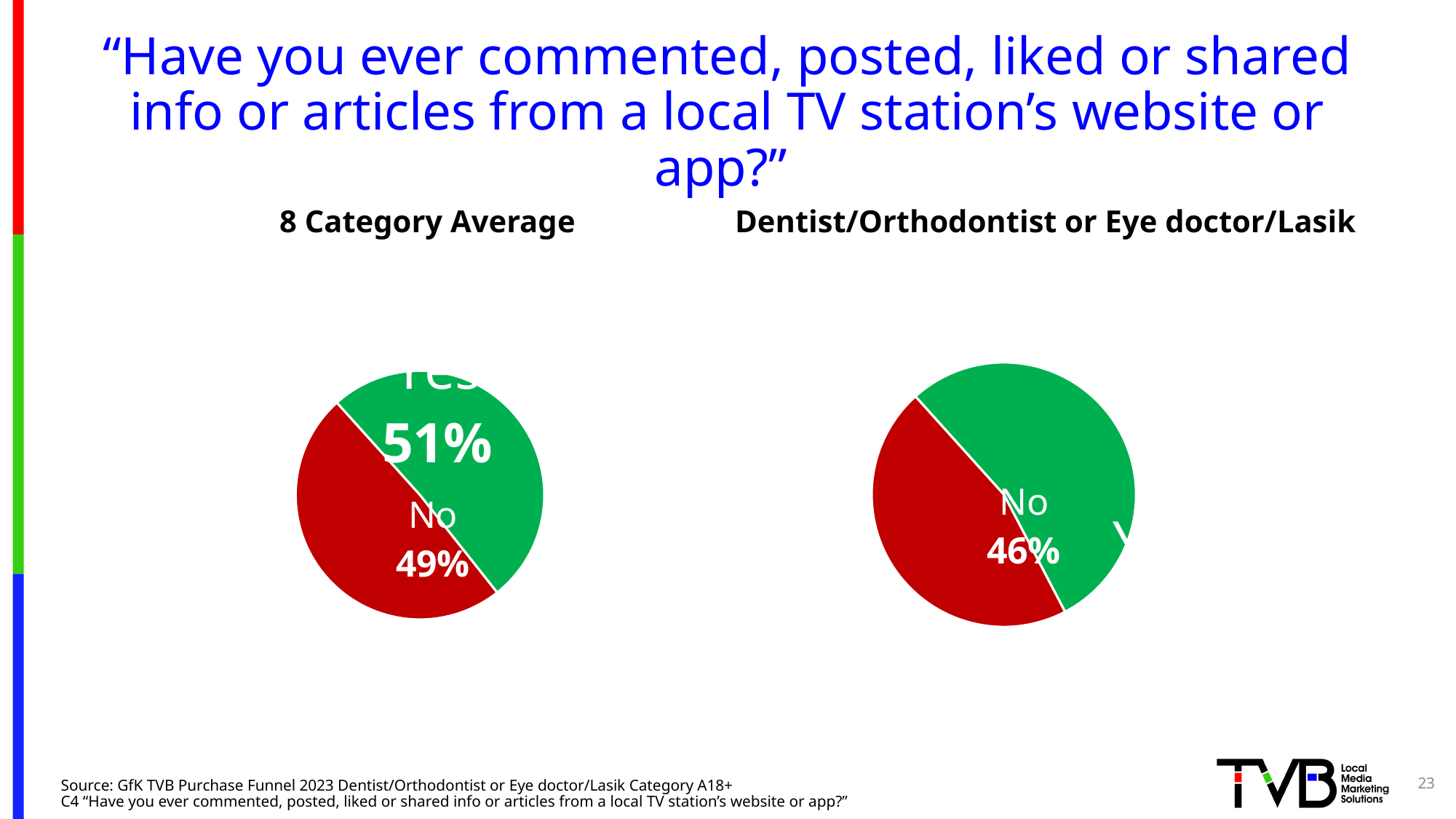
What colour represents the No slice in the pie charts? Red In the Dentist/Orthodontist or Eye doctor/Lasik pie chart, what percentage answered No? 46% What type of chart is used for the 8 Category Average? Pie chart How many pie charts are shown on the slide? 2 In the 8 Category Average pie chart, what percentage answered Yes? 51% In the 8 Category Average pie chart, which response has the larger share, Yes or No? Yes What is the title of the pie chart on the right? Dentist/Orthodontist or Eye doctor/Lasik In the Dentist/Orthodontist or Eye doctor/Lasik pie chart, which slice is larger, Yes or No? Yes How many slices does the Dentist/Orthodontist or Eye doctor/Lasik pie chart have? 2 Is the No share in the Dentist/Orthodontist or Eye doctor/Lasik pie chart greater or less than 50%? less In the 8 Category Average pie chart, what percentage answered No? 49% In the 8 Category Average pie chart, what is the difference between the Yes and No percentages? 2%